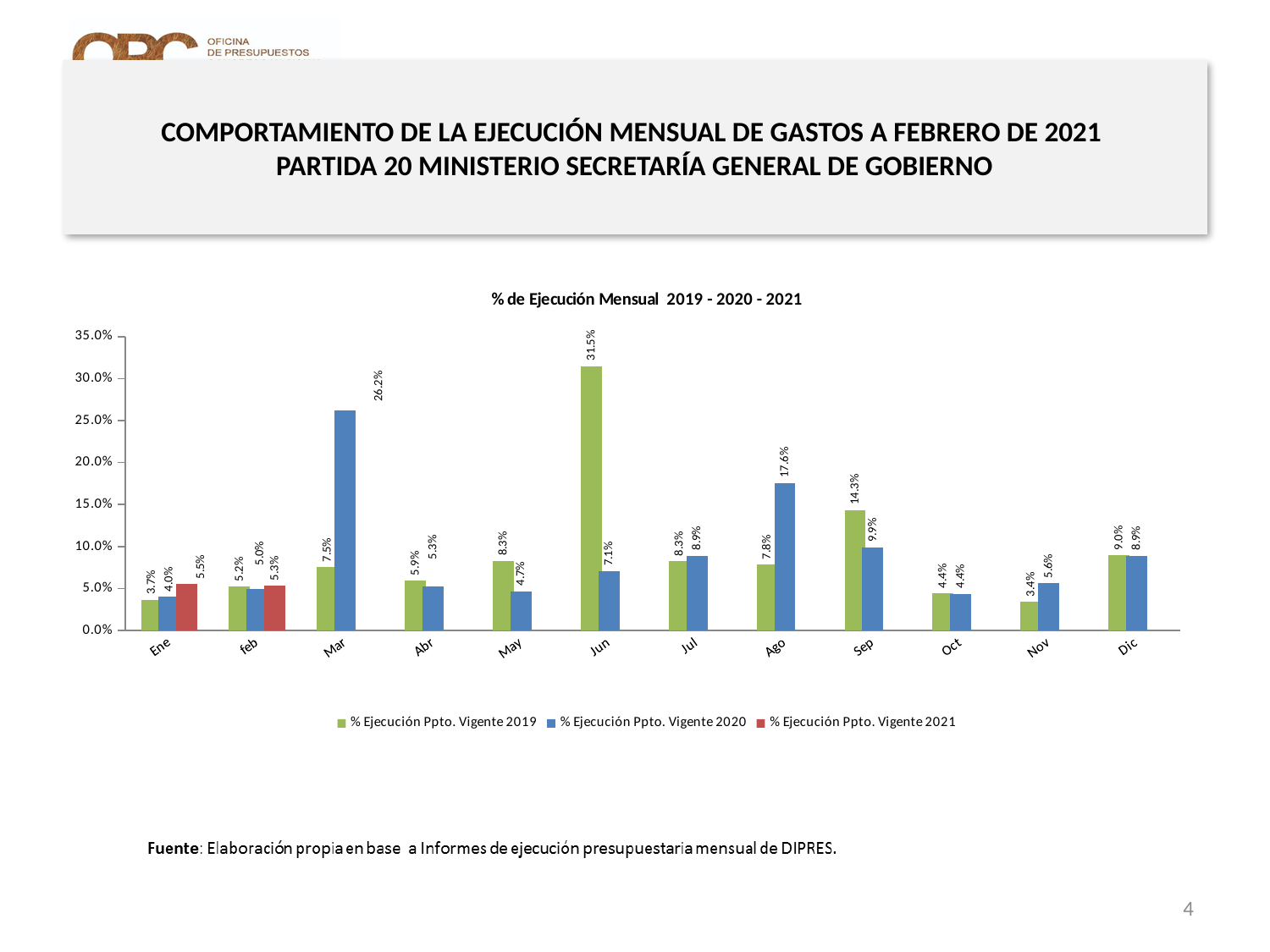
What kind of chart is shown on the slide? Bar chart How many months are shown on the x axis? 12 What is the value for % Ejecución Ppto. Vigente 2019 in Sep? 14.3% In Jun, which series has the larger value, 2019 or 2020? 2019 What is the value for % Ejecución Ppto. Vigente 2020 in Mar? 26.2% What is the difference between the 2020 and 2019 values in Ago? 9.8% Which month has the lowest value for % Ejecución Ppto. Vigente 2019? Nov Which month has the highest value for % Ejecución Ppto. Vigente 2019? Jun How many series does the legend list? 3 What is the title of the chart? % de Ejecución Mensual 2019 - 2020 - 2021 Is the value for % Ejecución Ppto. Vigente 2020 in Mar greater or less than 25.0%? greater What is the value for % Ejecución Ppto. Vigente 2021 in Ene? 5.5%